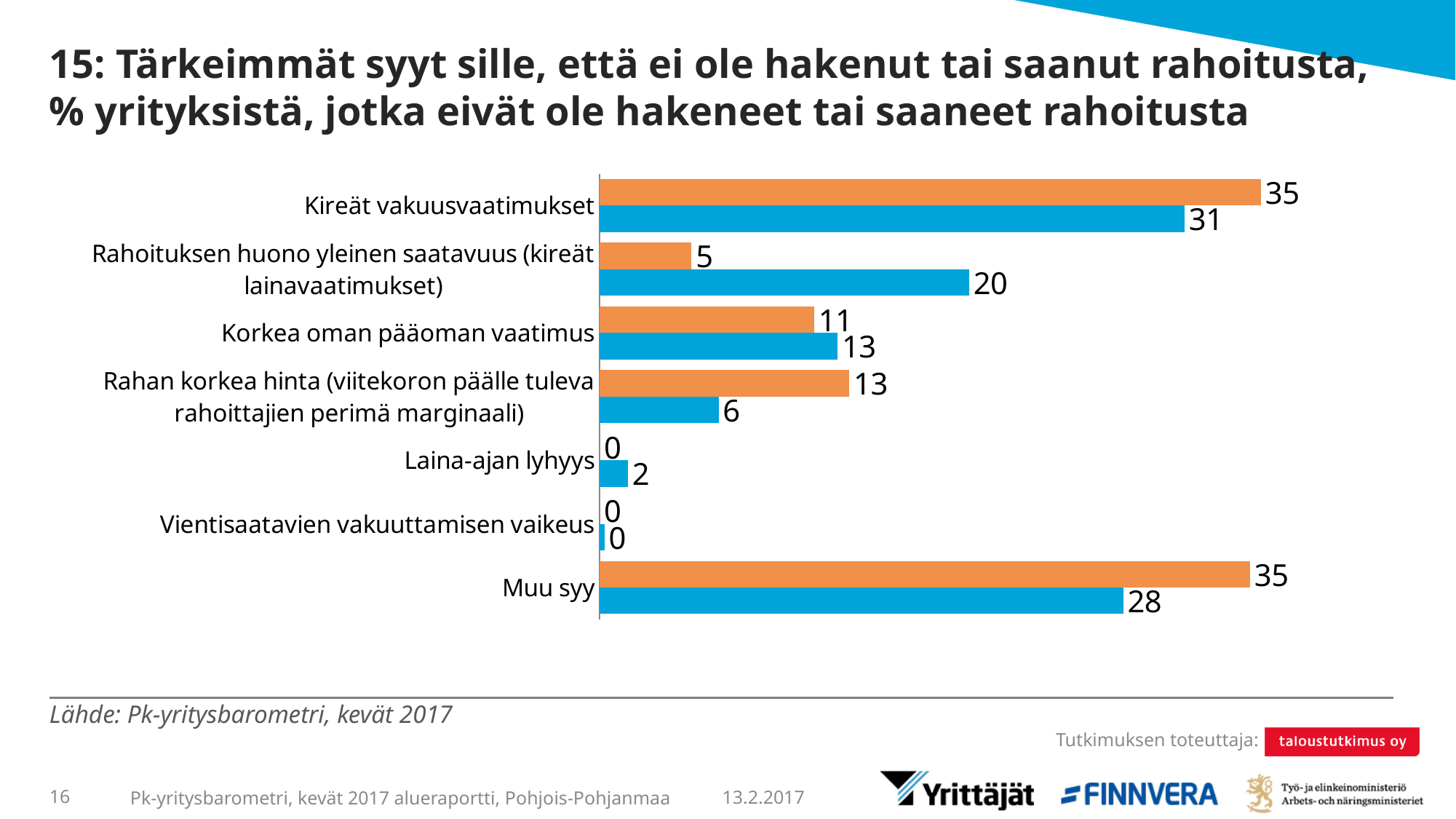
What is the difference between the orange and blue bars for Rahoituksen huono yleinen saatavuus (kireät lainavaatimukset)? 15 Which category has the lowest value among the blue bars? Vientisaatavien vakuuttamisen vaikeus How many categories are shown on the chart? 7 What is the source cited below the chart? Pk-yritysbarometri, kevät 2017 For Korkea oman pääoman vaatimus, which bar is larger, the orange or the blue? blue What kind of chart is shown on the slide? bar chart What is the value of the blue bar for Muu syy? 28 What is the value of the blue bar for Rahoituksen huono yleinen saatavuus (kireät lainavaatimukset)? 20 What is the value of the orange bar for Kireät vakuusvaatimukset? 35 What is the difference between the orange and blue bars for Muu syy? 7 Which category has the highest value among the blue bars? Kireät vakuusvaatimukset What is the value of the orange bar for Rahan korkea hinta (viitekoron päälle tuleva rahoittajien perimä marginaali)? 13